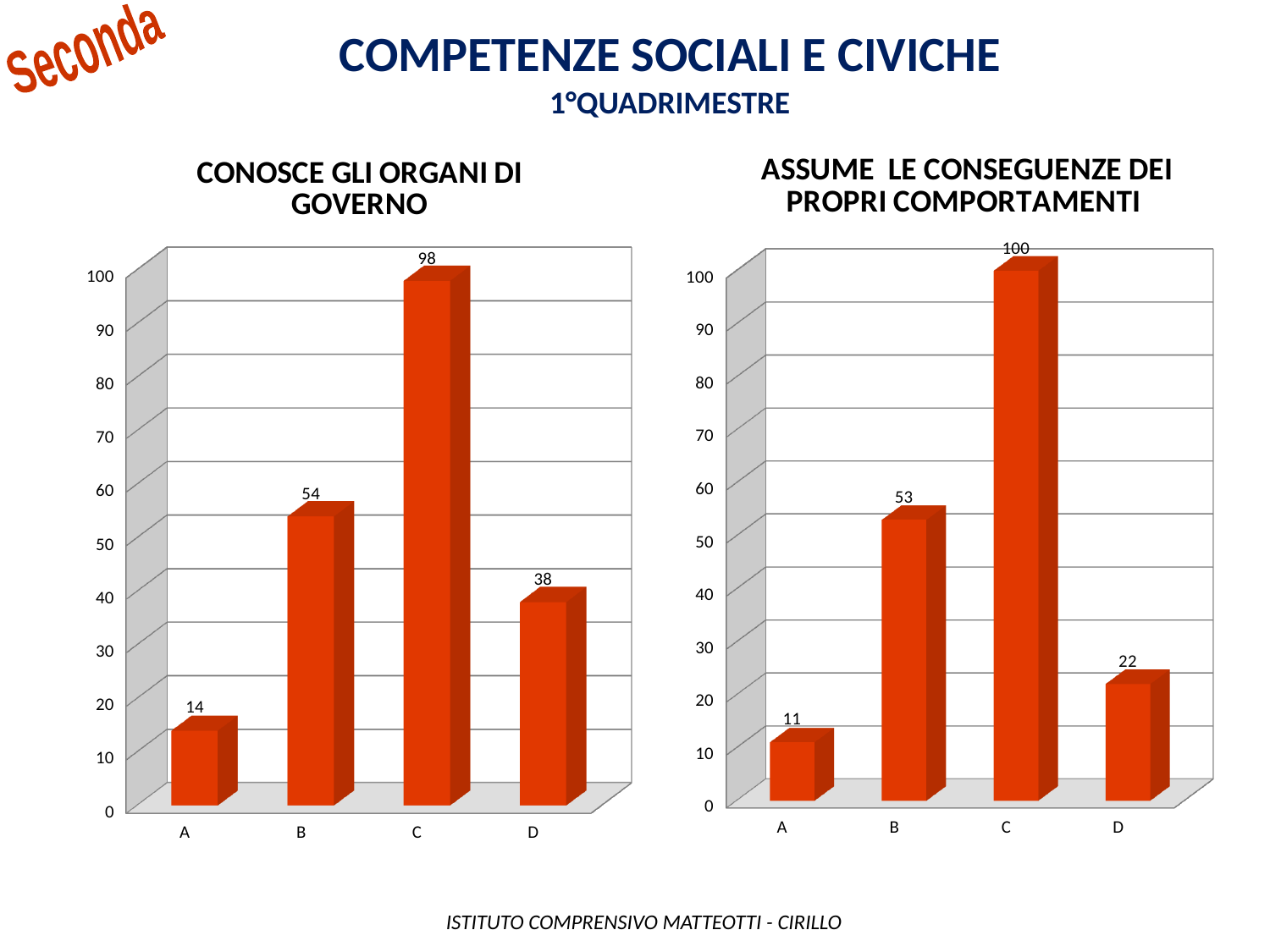
How many categories are shown in the chart titled 'CONOSCE GLI ORGANI DI GOVERNO'? 4 In the chart titled 'ASSUME LE CONSEGUENZE DEI PROPRI COMPORTAMENTI', is the value for D greater or less than 30? less In the chart titled 'ASSUME LE CONSEGUENZE DEI PROPRI COMPORTAMENTI', what is the value for category A? 11 In the chart titled 'CONOSCE GLI ORGANI DI GOVERNO', which is larger, the value for B or the value for D? B In the chart titled 'CONOSCE GLI ORGANI DI GOVERNO', what is the value for category D? 38 What is the title of the chart on the right side of the slide? ASSUME LE CONSEGUENZE DEI PROPRI COMPORTAMENTI In the chart titled 'CONOSCE GLI ORGANI DI GOVERNO', what is the value for category C? 98 In the chart titled 'ASSUME LE CONSEGUENZE DEI PROPRI COMPORTAMENTI', what is the difference between the values for C and B? 47 What kind of chart is the chart titled 'ASSUME LE CONSEGUENZE DEI PROPRI COMPORTAMENTI'? Bar chart In the chart titled 'CONOSCE GLI ORGANI DI GOVERNO', what is the difference between the values for B and D? 16 In the chart titled 'CONOSCE GLI ORGANI DI GOVERNO', which category has the lowest value? A In the chart titled 'ASSUME LE CONSEGUENZE DEI PROPRI COMPORTAMENTI', which category has the highest value? C